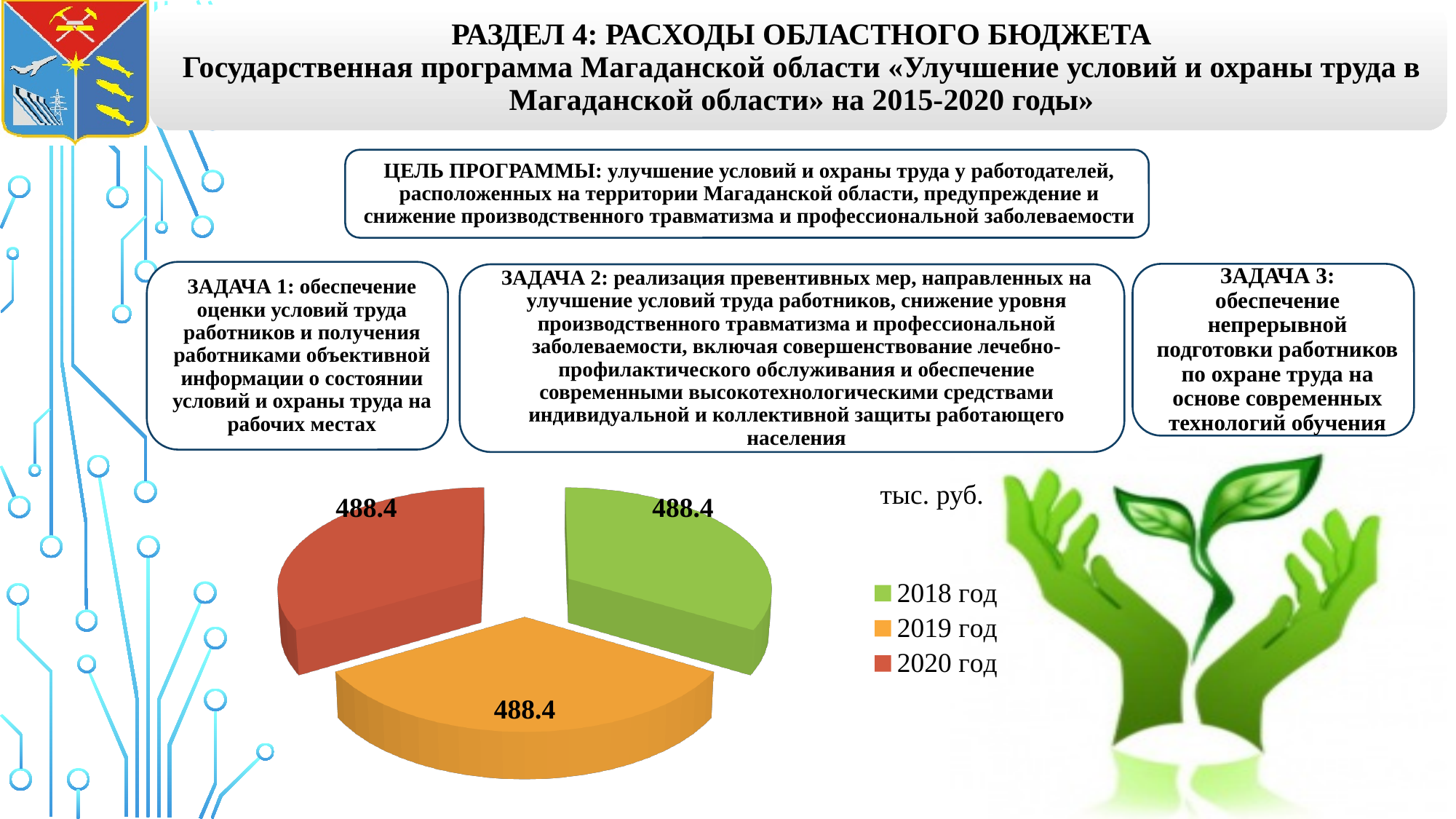
What kind of chart is shown on the slide? pie chart What is the value for 2020 год in the pie chart? 488.4 How many entries does the legend of the pie chart list? 3 What unit is indicated next to the pie chart? тыс. руб. What is the value for 2019 год in the pie chart? 488.4 Is the value for 2019 год larger than, smaller than, or equal to the value for 2018 год? equal Which colour represents 2019 год in the pie chart? orange How many slices does the pie chart have? 3 What is the difference between the values for 2018 год and 2020 год in the pie chart? 0 What is the value for 2018 год in the pie chart? 488.4 What is the total of all three slices in the pie chart? 1465.2